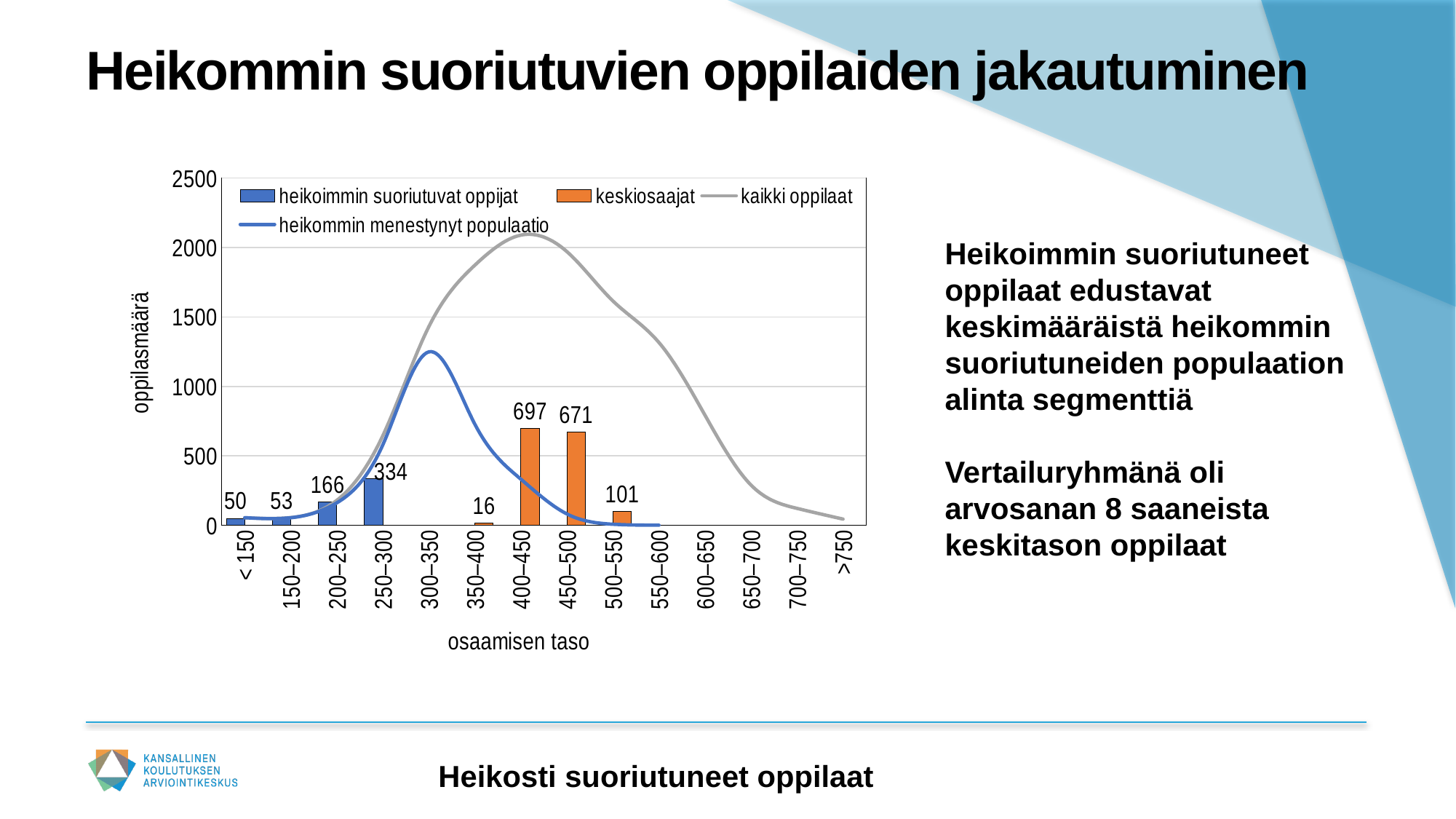
What is the difference between the heikoimmin suoriutuvat oppijat values for 250–300 and 200–250? 168 What is the difference between the keskiosaajat values for 400–450 and 450–500? 26 How many categories are shown on the x axis? 14 What is the value for the 250–300 category in the heikoimmin suoriutuvat oppijat series? 334 Is the kaikki oppilaat line value at 400–450 greater or less than 2000? greater How many series does the legend list? 4 What is the value for the 400–450 category in the keskiosaajat series? 697 Which category has the lowest value in the keskiosaajat series? 350–400 Which category has the highest value in the keskiosaajat series? 400–450 What is the value for the 500–550 category in the keskiosaajat series? 101 What is the value for the < 150 category in the heikoimmin suoriutuvat oppijat series? 50 Which is larger: the heikoimmin suoriutuvat oppijat value for 150–200 or for 200–250? 200–250